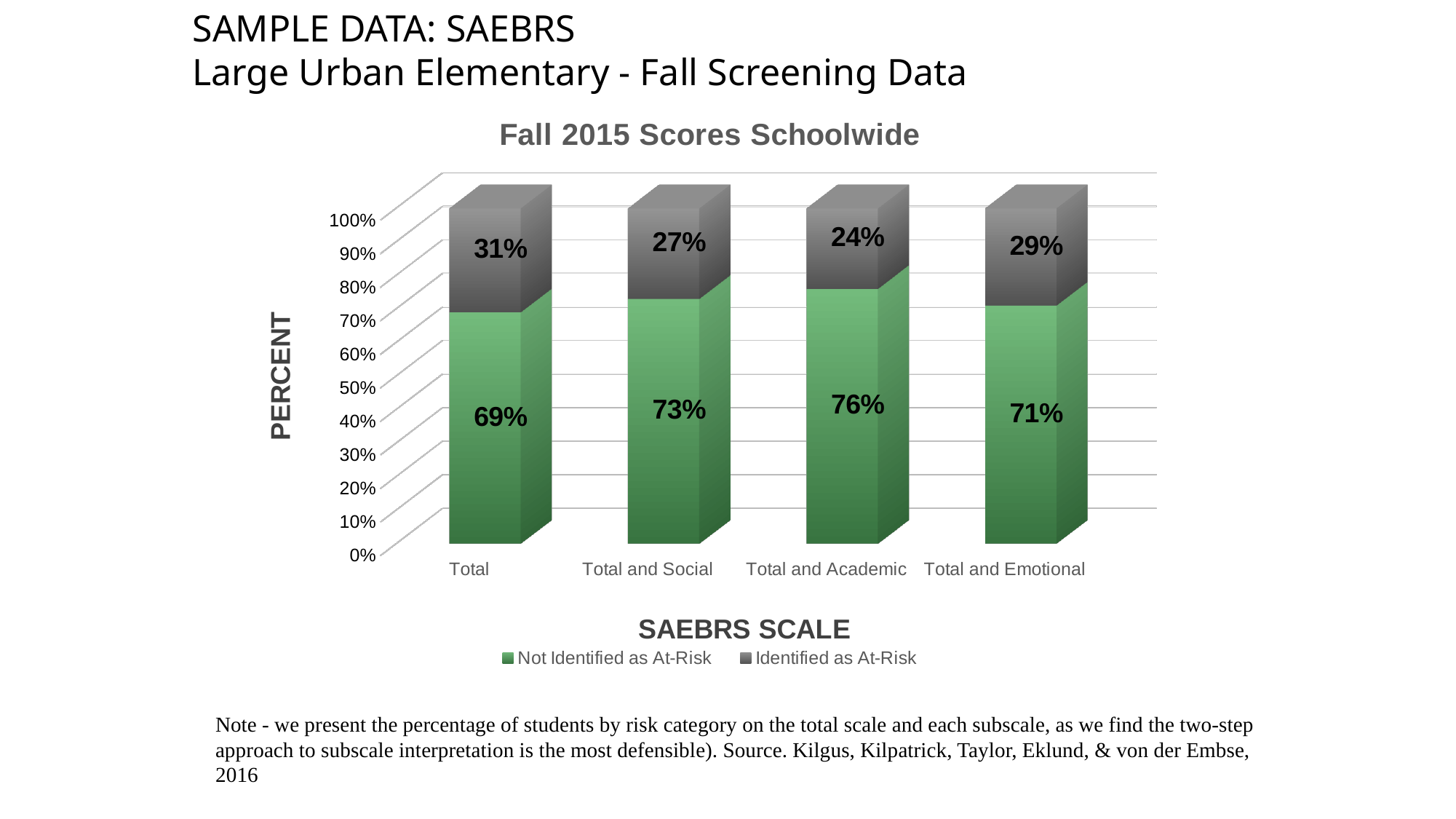
What percentage of students were Identified as At-Risk on the Total and Academic scale? 24% What percentage of students were Not Identified as At-Risk on the Total scale? 69% Which SAEBRS scale has the highest percentage of students Not Identified as At-Risk? Total and Academic Which SAEBRS scale has the lowest percentage of students Identified as At-Risk? Total and Academic How many SAEBRS scale categories are shown on the x axis? 4 What is the difference between the Identified as At-Risk percentages for Total and Total and Social? 4% What percentage of students were Identified as At-Risk on the Total and Emotional scale? 29% What is the title of the chart? Fall 2015 Scores Schoolwide What kind of chart is shown on the slide? Stacked bar chart Which is larger: the Not Identified as At-Risk percentage for Total and Social or for Total and Emotional? Total and Social How many series does the legend list? 2 What is the total of the stacked bar for Total and Social? 100%